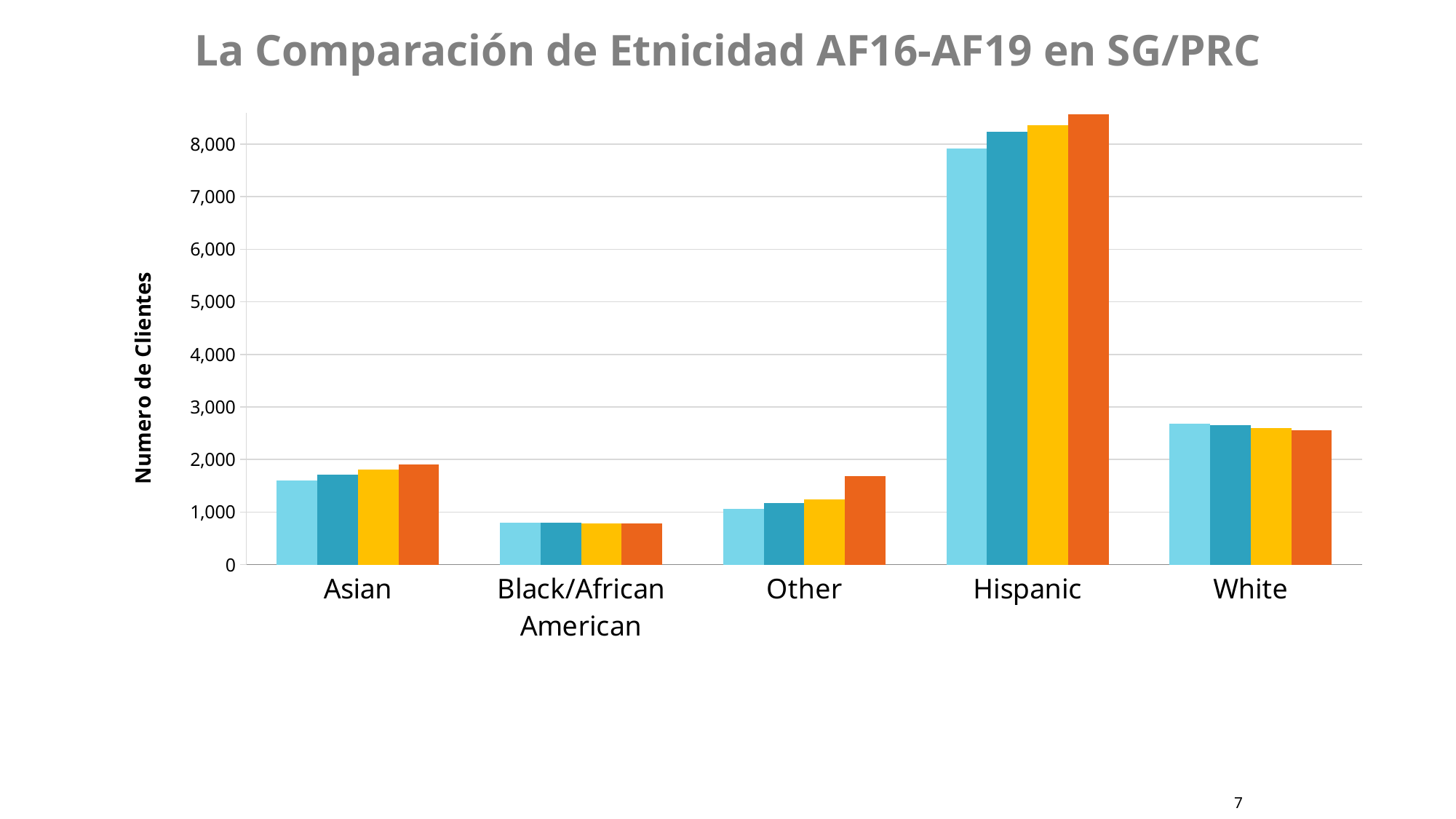
Which ethnicity category has the highest bars? Hispanic Which category has larger values, Hispanic or White? Hispanic Are the values for White greater or less than 3,000? less Are the values for Black/African American greater or less than 1,000? less How many ethnicity categories are shown on the x axis? 5 What is the label on the vertical axis? Numero de Clientes Within the Asian category, do the bars rise or fall from left to right? rise Are the values for Hispanic greater or less than 7,000? greater How many bars are plotted for each ethnicity category? 4 Which ethnicity category has the lowest bars? Black/African American What type of chart is shown on the slide? bar chart